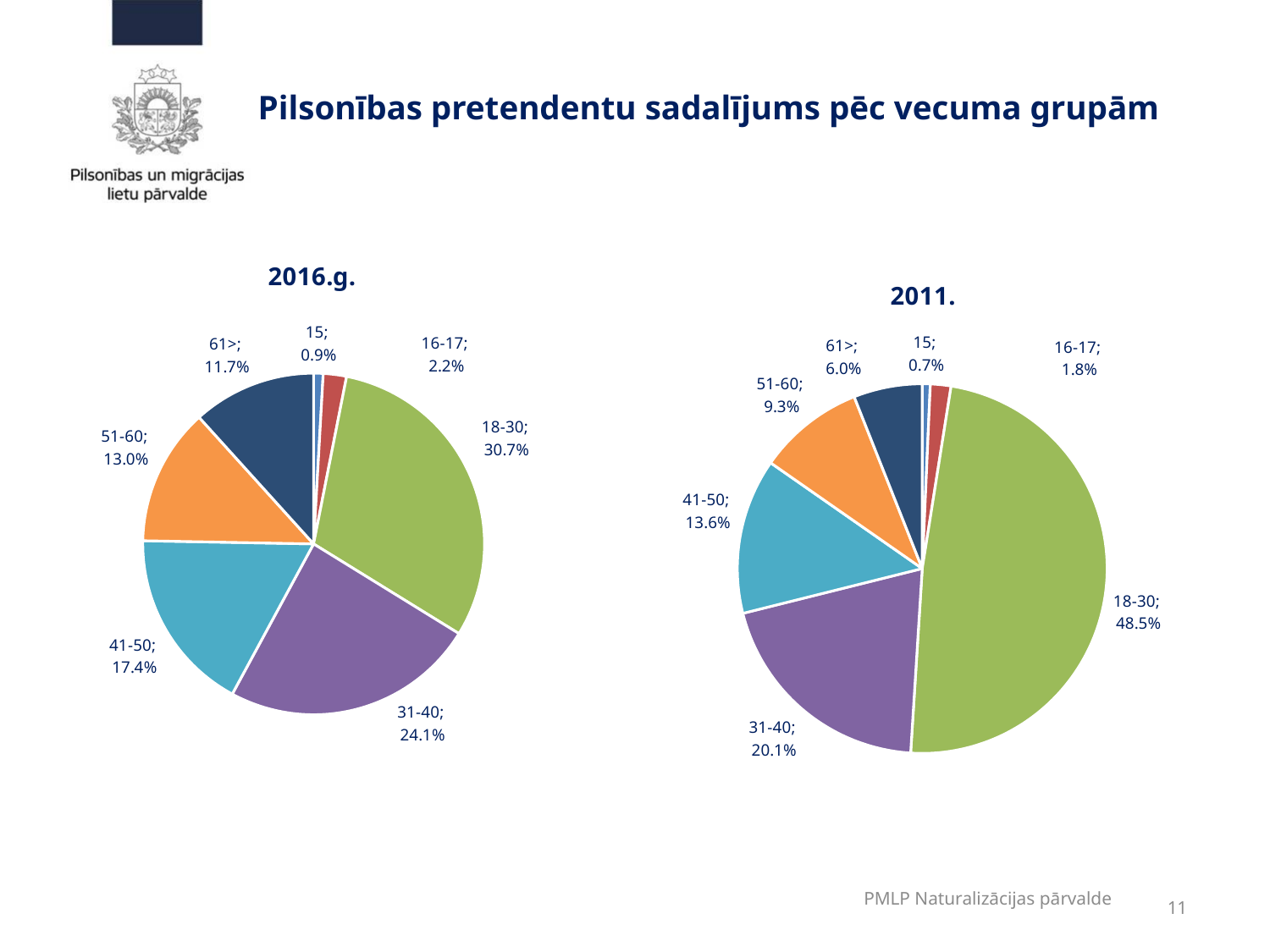
What kind of chart is used for the 2011. data? Pie chart What is the title of the slide containing the two pie charts? Pilsonības pretendentu sadalījums pēc vecuma grupām In the 2016.g. pie chart, what share does the 18-30 age group have? 30.7% In the 2011. pie chart, what share does the 41-50 age group have? 13.6% In the 2016.g. pie chart, which age group has the smallest share? 15 How many slices does the 2016.g. pie chart have? 7 In the 2011. pie chart, which age group has the largest share? 18-30 In the 2016.g. pie chart, what is the difference between the shares of the 31-40 and 41-50 age groups? 6.7% In the 2016.g. pie chart, what share does the 61> age group have? 11.7% Which is larger in the 2011. pie chart: the share of 51-60 or the share of 61>? 51-60 What is the difference between the 18-30 share in the 2011. chart and the 18-30 share in the 2016.g. chart? 17.8% In the 2011. pie chart, what share does the 31-40 age group have? 20.1%